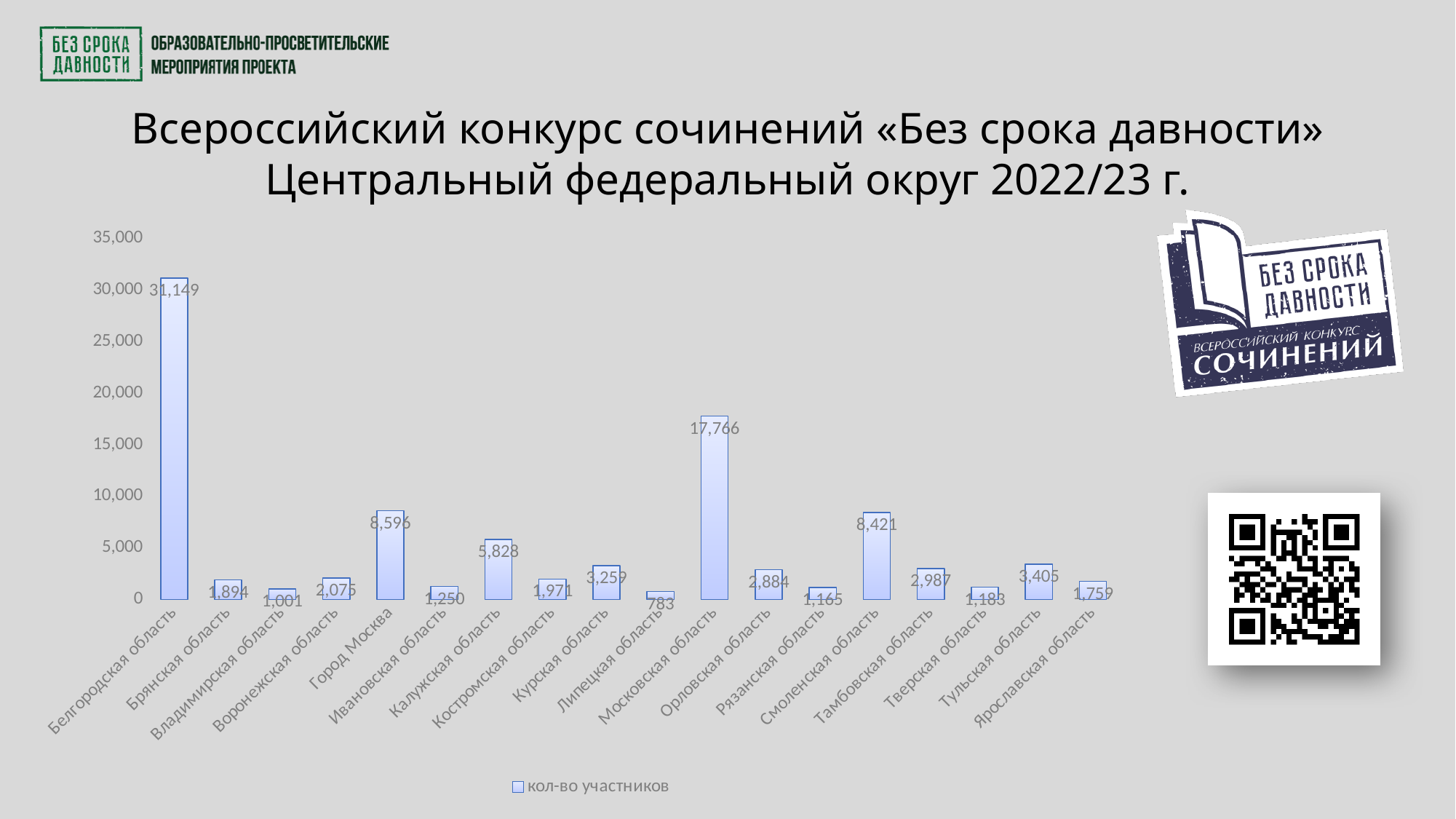
How many regions are shown on the x axis? 18 What is the value for Белгородская область? 31,149 Which region has the lowest value? Липецкая область Is the value for Московская область greater or less than 15,000? greater What is the difference between the values for Белгородская область and Московская область? 13,383 What is the value for Московская область? 17,766 What is the value for Калужская область? 5,828 What is the value for Город Москва? 8,596 How many series does the legend list? 1 What kind of chart is shown on the slide? bar chart Which region has the highest value? Белгородская область Which is larger, the value for Город Москва or the value for Калужская область? Город Москва